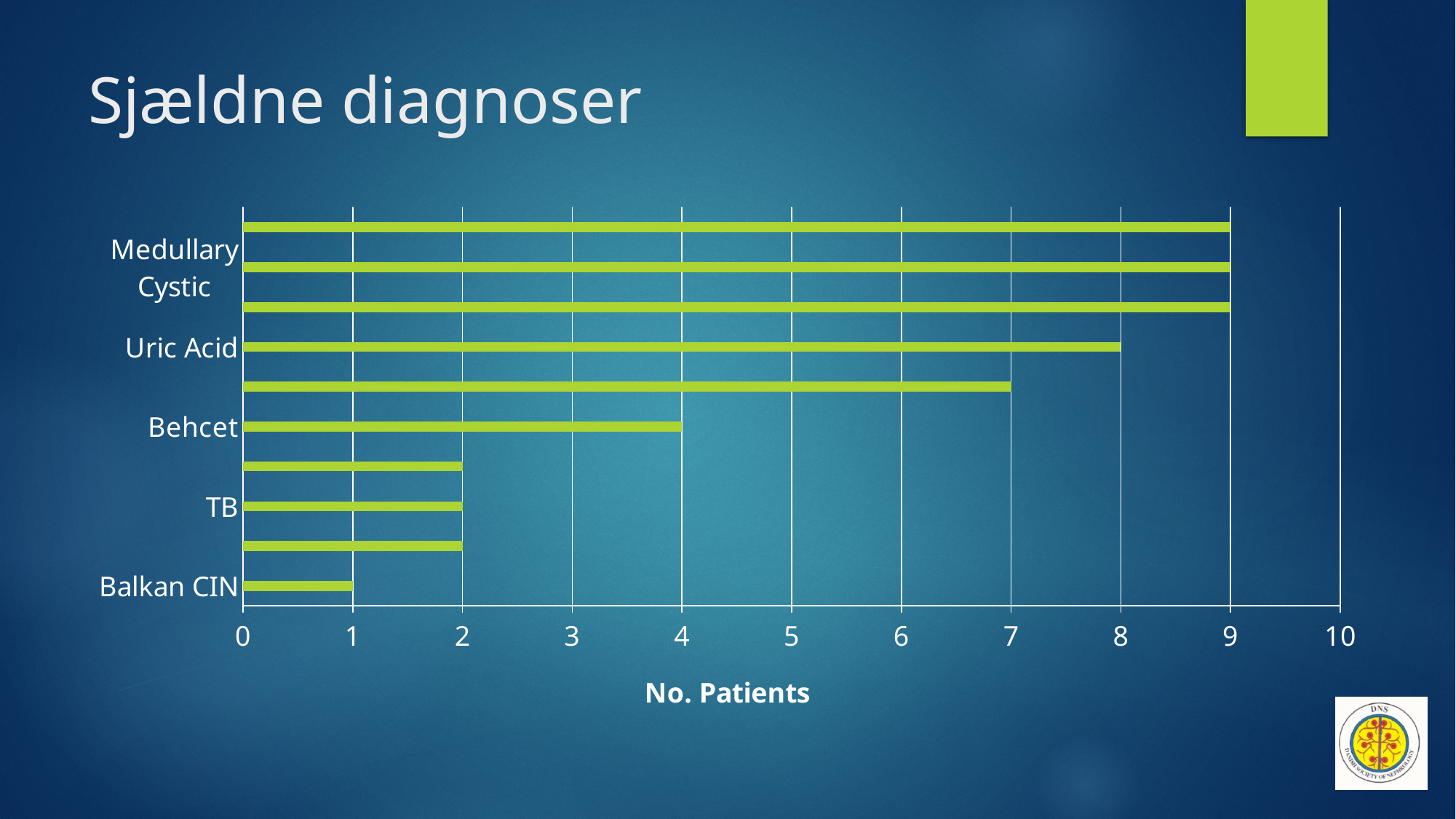
What is the value for TB? 2 What is the title of the horizontal axis? No. Patients Is the value for Behcet greater or less than 5? less What is the value for Balkan CIN? 1 What is the value for Uric Acid? 8 What is the value for Behcet? 4 What kind of chart is shown on the slide? bar chart What is the difference between the values for Uric Acid and Behcet? 4 Which labelled category has the lowest value? Balkan CIN What is the value for Medullary Cystic? 9 Which is larger, the value for Behcet or the value for TB? Behcet How many bars are plotted in the chart? 10